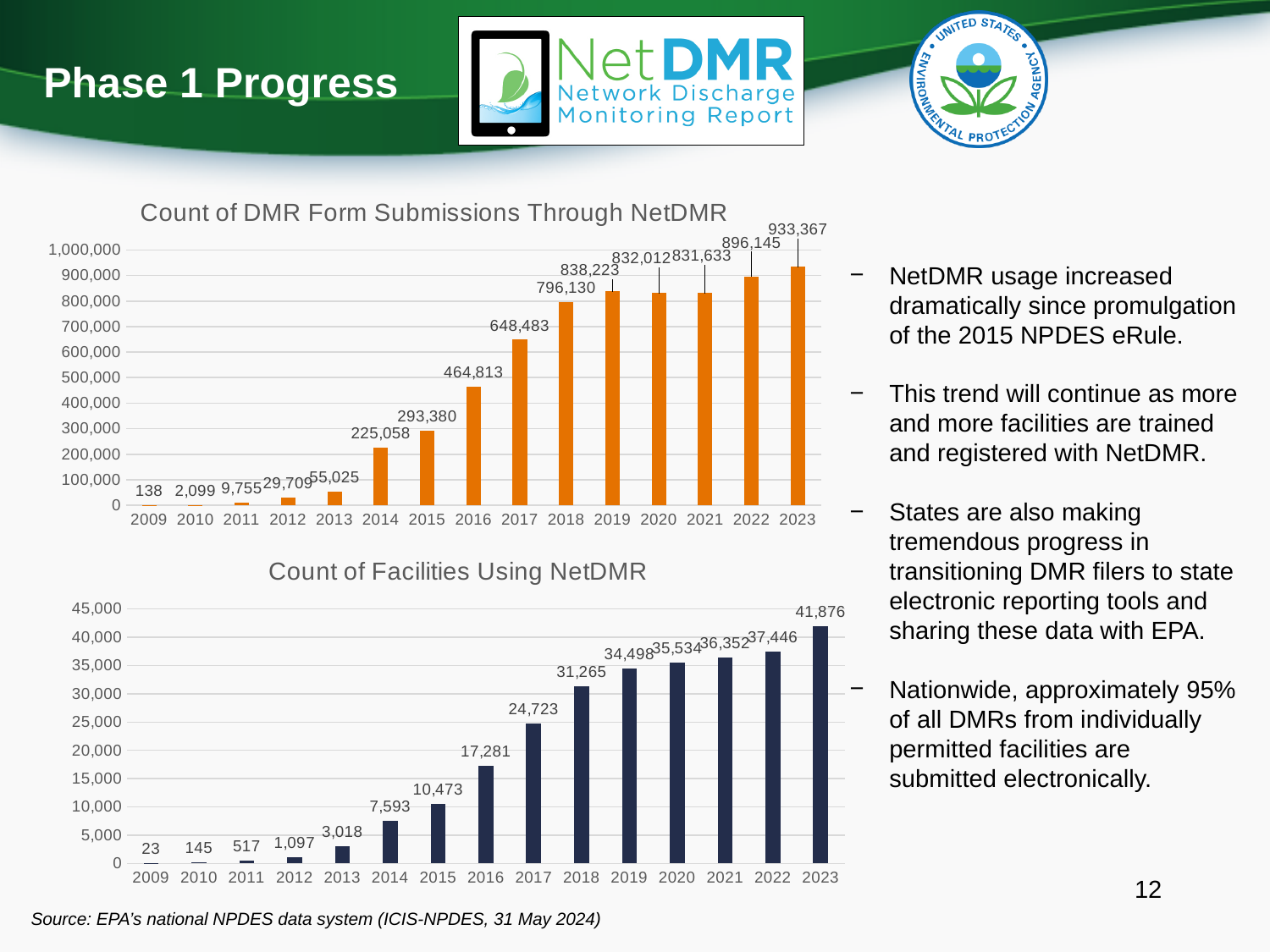
In the 'Count of DMR Form Submissions Through NetDMR' chart, what is the value for 2016? 464,813 In the 'Count of Facilities Using NetDMR' chart, which year has the highest value? 2023 In the 'Count of DMR Form Submissions Through NetDMR' chart, which is larger, the value for 2019 or the value for 2020? 2019 In the 'Count of Facilities Using NetDMR' chart, is the value for 2018 greater or less than 30,000? greater In the 'Count of DMR Form Submissions Through NetDMR' chart, what is the difference between the 2023 and 2022 values? 37,222 In the 'Count of DMR Form Submissions Through NetDMR' chart, what is the value for 2023? 933,367 In the 'Count of Facilities Using NetDMR' chart, what is the value for 2017? 24,723 In the 'Count of Facilities Using NetDMR' chart, do the values rise or fall from 2009 to 2023? Rise In the 'Count of DMR Form Submissions Through NetDMR' chart, which year has the lowest value? 2009 In the 'Count of DMR Form Submissions Through NetDMR' chart, how many years are shown on the x axis? 15 What kind of chart is the 'Count of Facilities Using NetDMR' chart? Bar chart In the 'Count of Facilities Using NetDMR' chart, what is the difference between the 2023 and 2022 values? 4,430